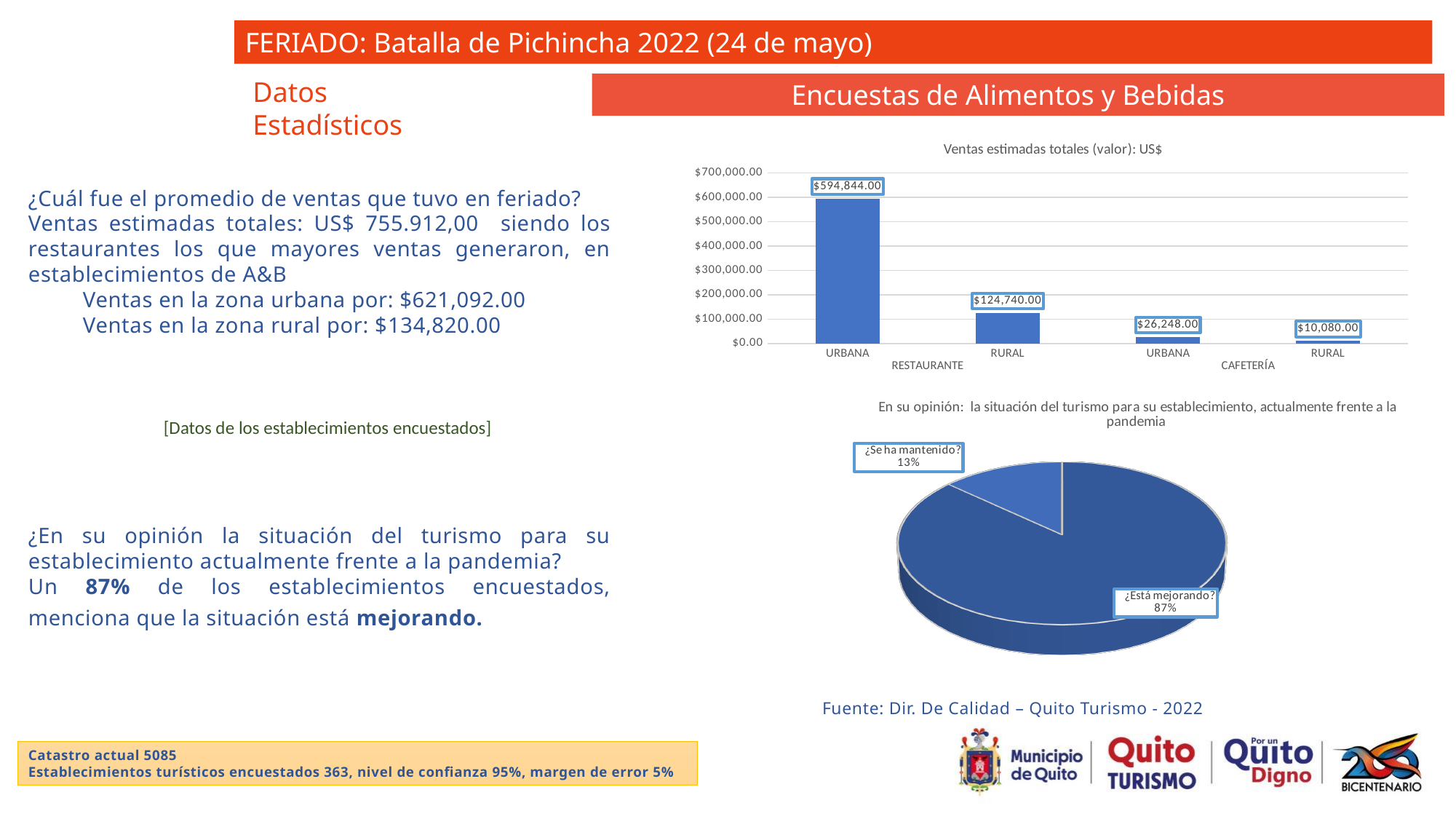
In the 'Ventas estimadas totales (valor): US$' bar chart, how many bars are plotted? 4 In the pie chart about the tourism situation versus the pandemic, what share corresponds to '¿Está mejorando?'? 87% In the 'Ventas estimadas totales (valor): US$' bar chart, which bar is the lowest? RURAL (CAFETERÍA) In the 'Ventas estimadas totales (valor): US$' bar chart, what is the difference between the URBANA and RURAL values under RESTAURANTE? $470,104.00 What kind of chart is the chart about the tourism situation versus the pandemic? Pie chart In the 'Ventas estimadas totales (valor): US$' bar chart, what is the value for URBANA under RESTAURANTE? $594,844.00 In the 'Ventas estimadas totales (valor): US$' bar chart, what is the value for RURAL under CAFETERÍA? $10,080.00 In the 'Ventas estimadas totales (valor): US$' bar chart, what is the value for URBANA under CAFETERÍA? $26,248.00 In the 'Ventas estimadas totales (valor): US$' bar chart, which is larger: RURAL under RESTAURANTE or URBANA under CAFETERÍA? RURAL under RESTAURANTE In the pie chart about the tourism situation versus the pandemic, what share corresponds to '¿Se ha mantenido?'? 13% In the 'Ventas estimadas totales (valor): US$' bar chart, which bar is the highest? URBANA (RESTAURANTE) What kind of chart is the 'Ventas estimadas totales (valor): US$' chart? Bar chart